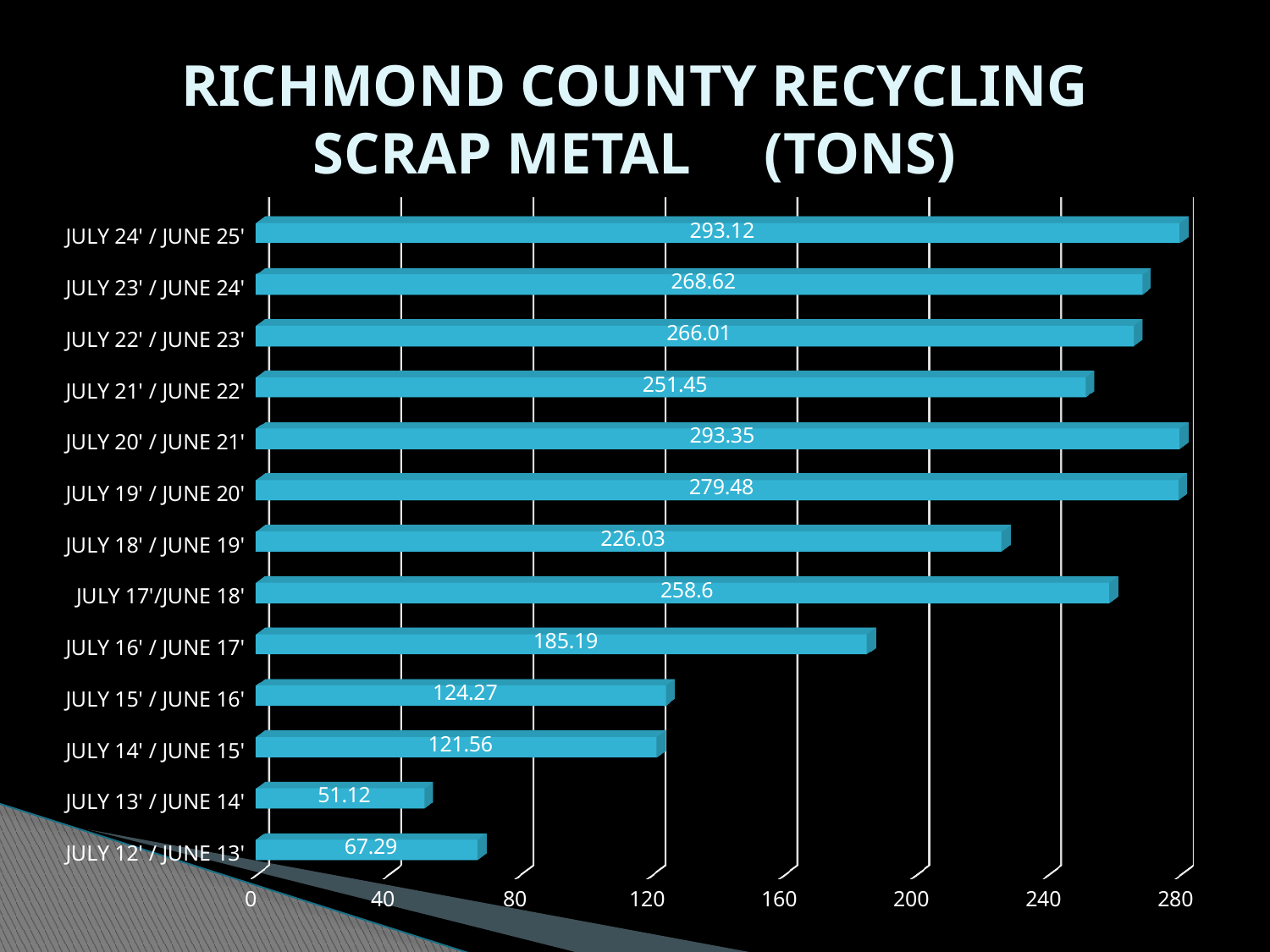
What is the scrap metal value for JULY 16' / JUNE 17'? 185.19 What kind of chart is shown on the slide? Bar chart What is the difference between the values for JULY 15' / JUNE 16' and JULY 14' / JUNE 15'? 2.71 What is the scrap metal value for JULY 24' / JUNE 25'? 293.12 How many periods are shown on the chart? 13 Which is larger, the value for JULY 18' / JUNE 19' or the value for JULY 17'/JUNE 18'? JULY 17'/JUNE 18' What is the scrap metal value for JULY 13' / JUNE 14'? 51.12 What is the title of the chart? RICHMOND COUNTY RECYCLING SCRAP METAL (TONS) What is the difference between the values for JULY 23' / JUNE 24' and JULY 22' / JUNE 23'? 2.61 Is the value for JULY 19' / JUNE 20' greater or less than 240? greater Which period has the lowest scrap metal value? JULY 13' / JUNE 14' Which is larger, the value for JULY 12' / JUNE 13' or the value for JULY 13' / JUNE 14'? JULY 12' / JUNE 13'